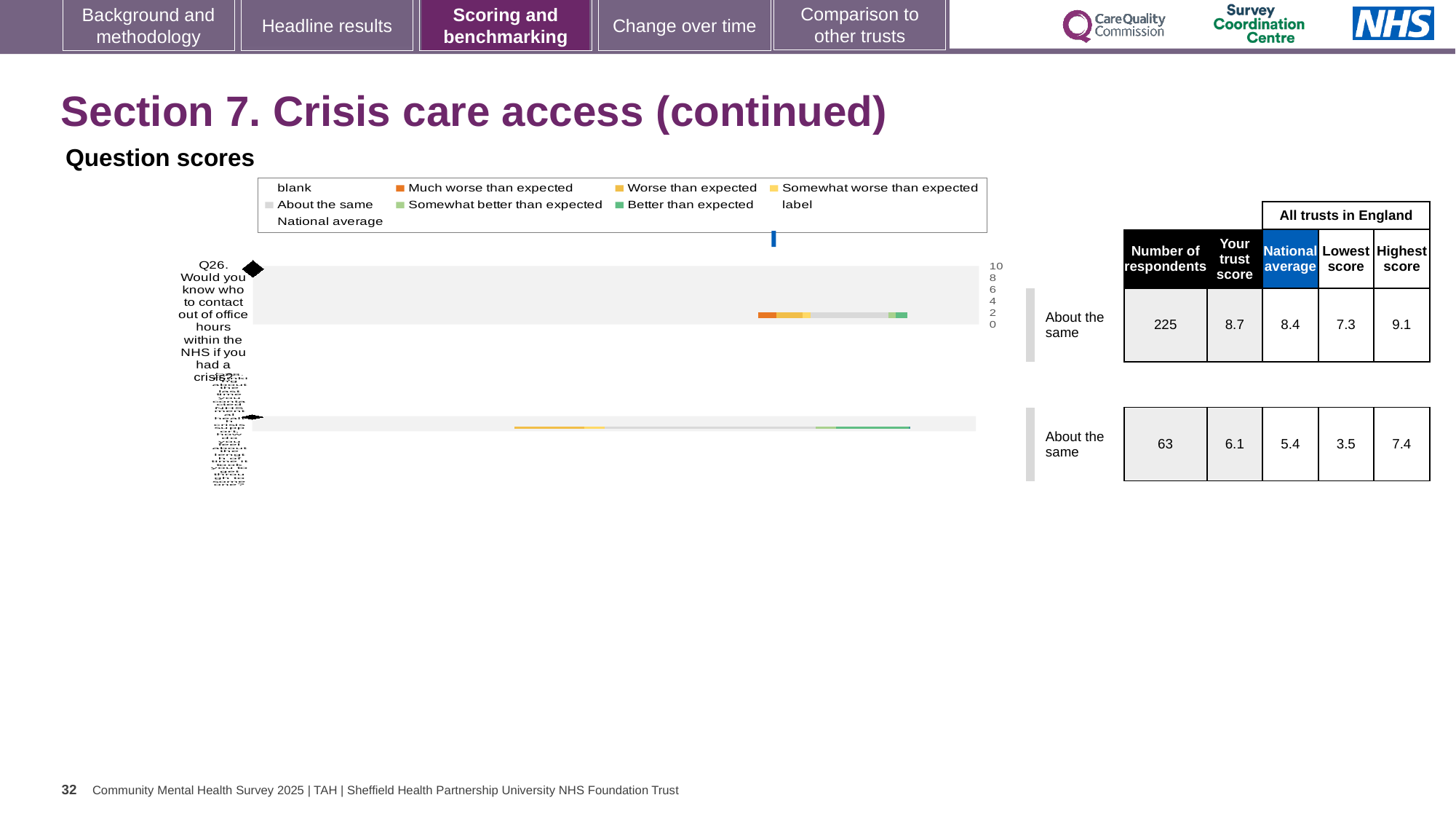
What is the highest score among all trusts in England for Q26? 9.1 What is the national average for Q26? 8.4 For the second question row, what is the difference between the trust score and the national average? 0.7 For Q26, which is larger: the trust score or the national average? the trust score For Q26, what is the difference between the highest and lowest scores among all trusts in England? 1.8 What is the trust score for Q26? 8.7 What is the number of respondents for the second question row in the chart? 63 What is the number of respondents for Q26 (Would you know who to contact out of office hours within the NHS if you had a crisis?)? 225 What is the lowest score among all trusts in England for Q26? 7.3 What kind of chart is used to show the question scores on this slide? bar chart How many questions are plotted as rows in the question scores chart? 2 What benchmark category is shown for Q26? About the same